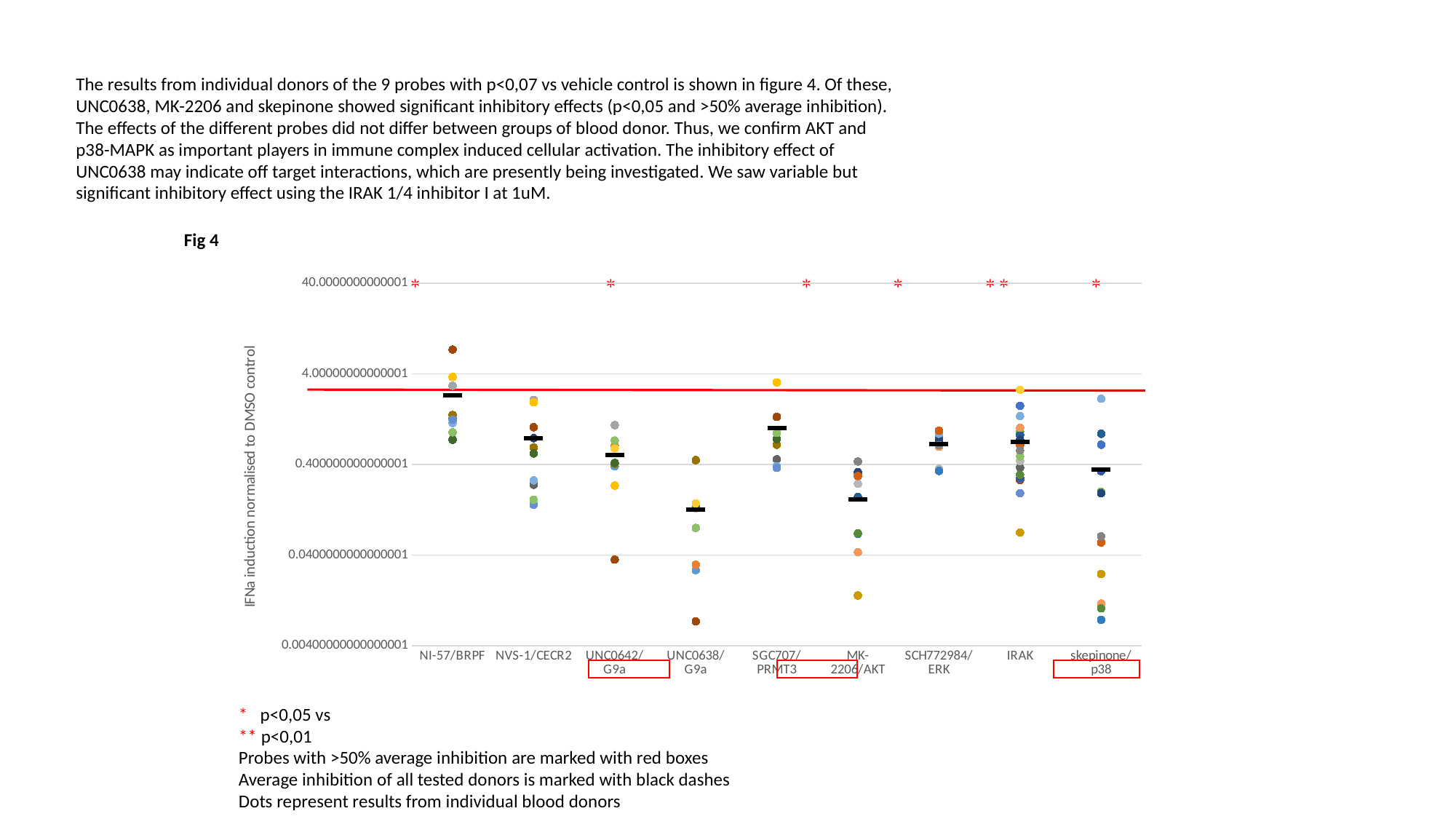
Is the average (black dash) for UNC0638/G9a larger or smaller than the average for MK-2206/AKT? smaller Is the average (black dash) for IRAK larger or smaller than the average for UNC0642/G9a? larger Which probe category has the highest average (black dash) in the chart? NI-57/BRPF Is the average (black dash) for UNC0638/G9a greater or less than 0.4? less How many probe categories are shown along the x axis of the chart? 9 Is the average (black dash) for SGC707/PRMT3 greater or less than 0.4? greater What is the label of the y axis of the chart? IFNa induction normalised to DMSO control Which probe category has the lowest average (black dash) in the chart? UNC0638/G9a What kind of chart is shown in Fig 4? scatter (dot) plot Is the average (black dash) for MK-2206/AKT greater or less than 0.4? less Which probe category is marked with two red asterisks at the top of the chart? IRAK